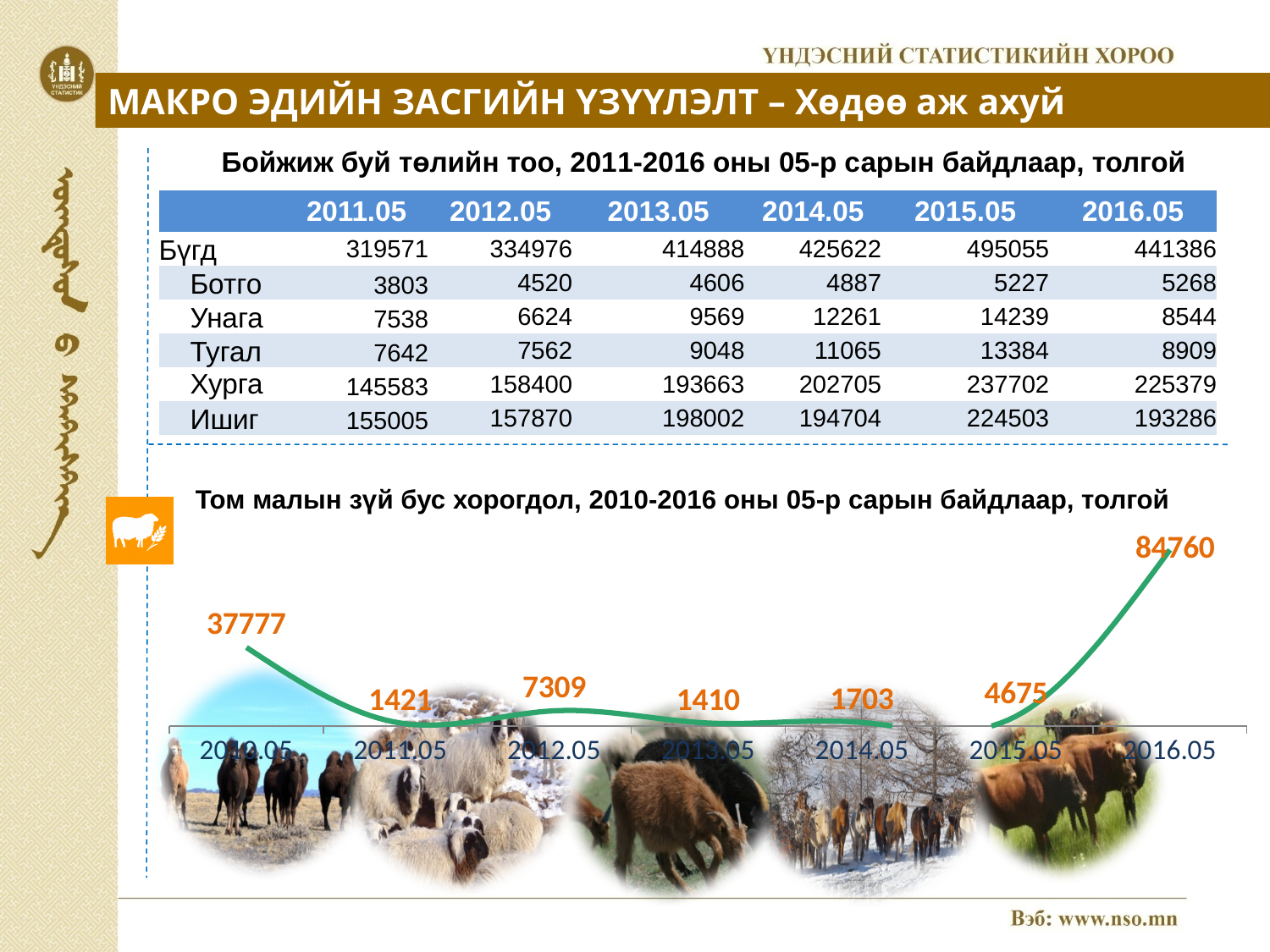
In the line chart, what is the value for 2010.05? 37777 In the line chart, what is the difference between the values for 2015.05 and 2014.05? 2972 In the line chart, what is the difference between the values for 2016.05 and 2010.05? 46983 In the line chart, what is the value for 2016.05? 84760 In the line chart, what is the value for 2012.05? 7309 What kind of chart is shown under the title 'Том малын зүй бус хорогдол, 2010-2016 оны 05-р сарын байдлаар, толгой'? line chart How many data points are plotted in the line chart? 7 In the line chart, which period has the lowest value? 2013.05 In the line chart, what is the value for 2015.05? 4675 In the line chart, do the values rise or fall from 2013.05 to 2016.05? rise In the line chart, which period has the highest value? 2016.05 In the line chart, which is larger, the value for 2012.05 or the value for 2015.05? 2012.05